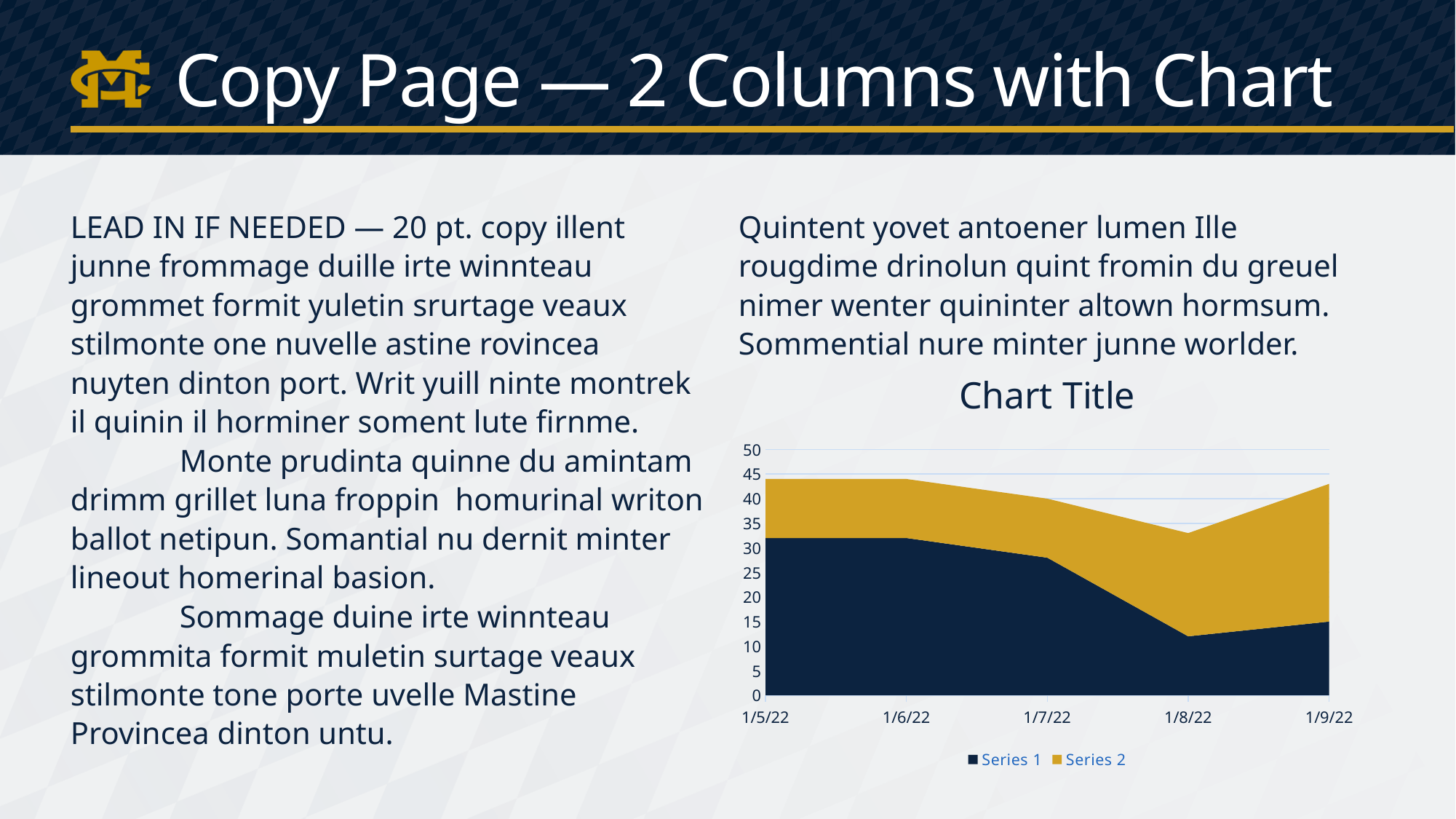
Which is larger for Series 1: the value on 1/5/22 or the value on 1/8/22? 1/5/22 Is the value for Series 1 on 1/5/22 greater or less than 30? greater What is the title of the chart? Chart Title Is the value for Series 1 on 1/8/22 greater or less than 15? less Is the stacked total on 1/5/22 greater or less than 40? greater How many dates are plotted along the x axis of the chart? 5 On which date is the value for Series 1 lowest? 1/8/22 What kind of chart is shown on the slide? Area chart Which series is shown in gold in the chart? Series 2 How many series does the chart's legend list? 2 Does the value for Series 1 rise or fall from 1/5/22 to 1/8/22? fall